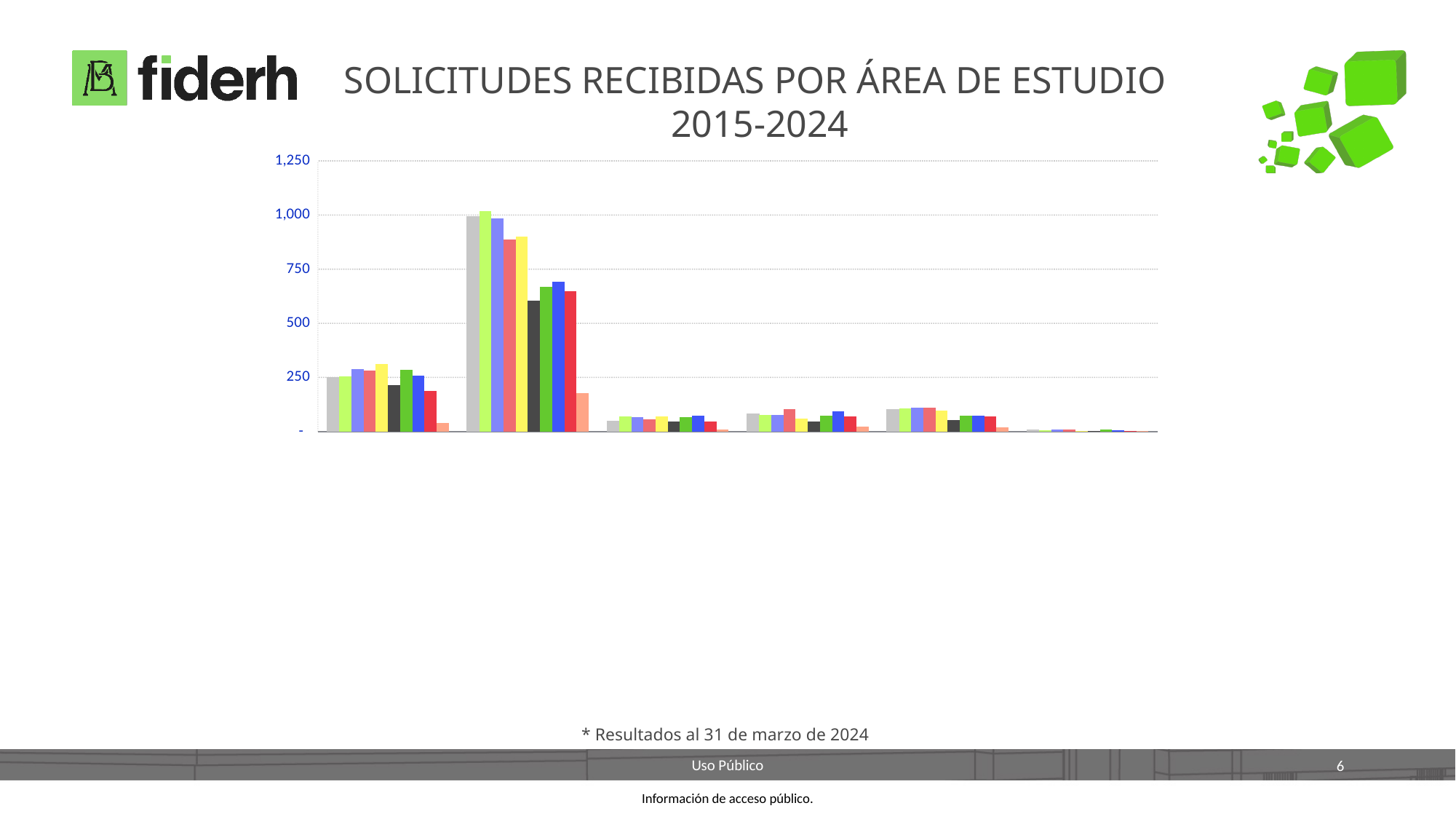
How many groups of bars are plotted along the x axis? 6 What kind of chart is shown on the slide? bar chart What is the highest value shown on the y axis? 1,250 Which group of bars has the lowest values overall? the sixth group from the left (rightmost) Which group of bars has the tallest bars? the second group from the left Is the tallest bar in the first group from the left greater or less than 500? less How many bars are there in each group? 10 Is the tallest bar in the third group from the left greater or less than 250? less Is the tallest bar in the first group from the left greater or less than 250? greater What is the title of the chart? SOLICITUDES RECIBIDAS POR ÁREA DE ESTUDIO 2015-2024